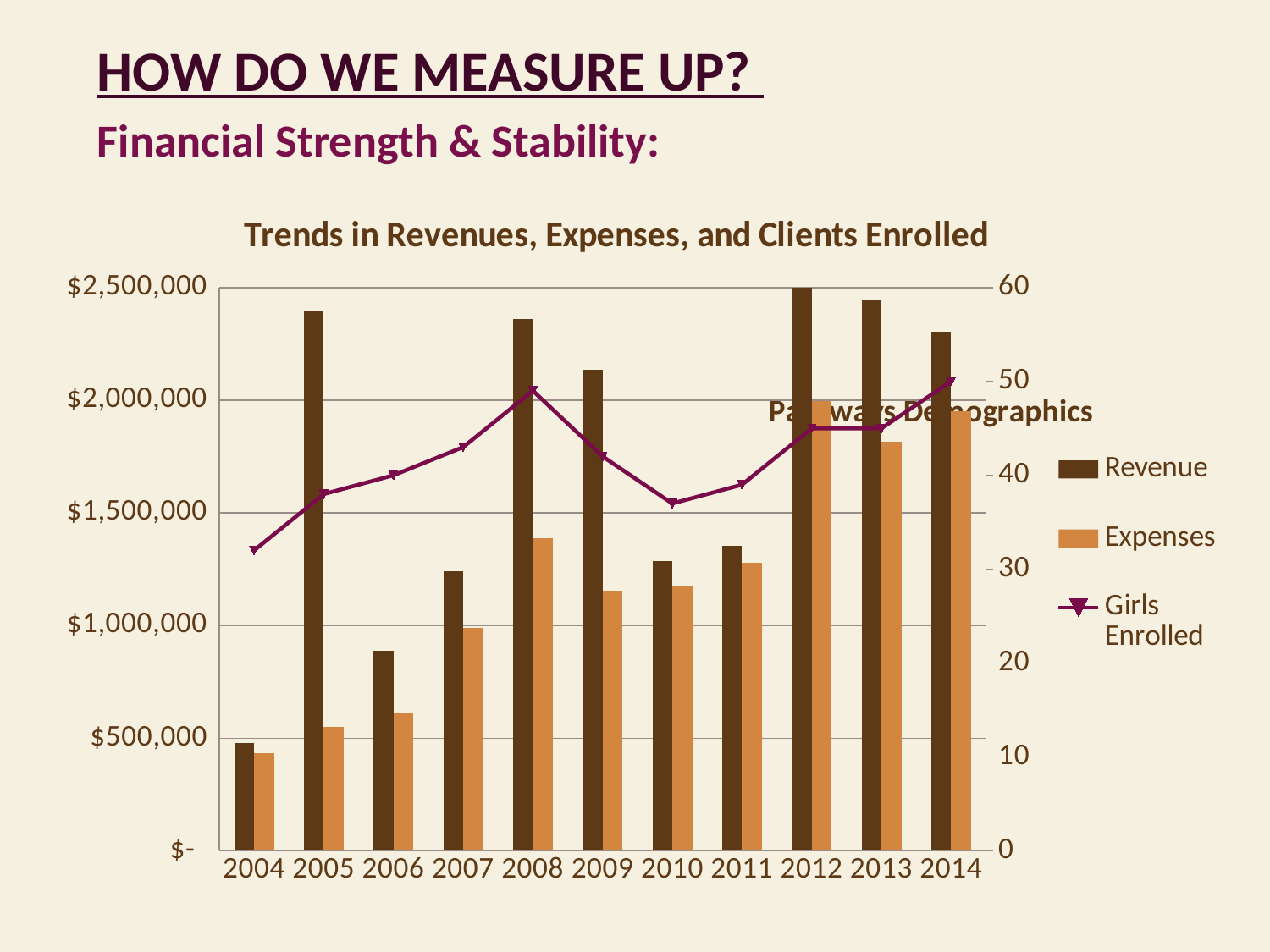
Which is larger in 2008, Revenue or Expenses? Revenue What kind of chart is shown on the slide? Bar chart with a line series Which year has the lowest number of Girls Enrolled? 2004 How many years are shown on the x axis of the chart? 11 Is the Revenue for 2006 greater or less than $1,000,000? less Is the Revenue for 2005 greater or less than $2,000,000? greater Which year has the lowest Revenue? 2004 Is the number of Girls Enrolled in 2010 greater or less than 40? less What is the title of the chart? Trends in Revenues, Expenses, and Clients Enrolled Which year has the highest Revenue? 2012 How many series does the chart legend list? 3 Which year has the lowest Expenses? 2004